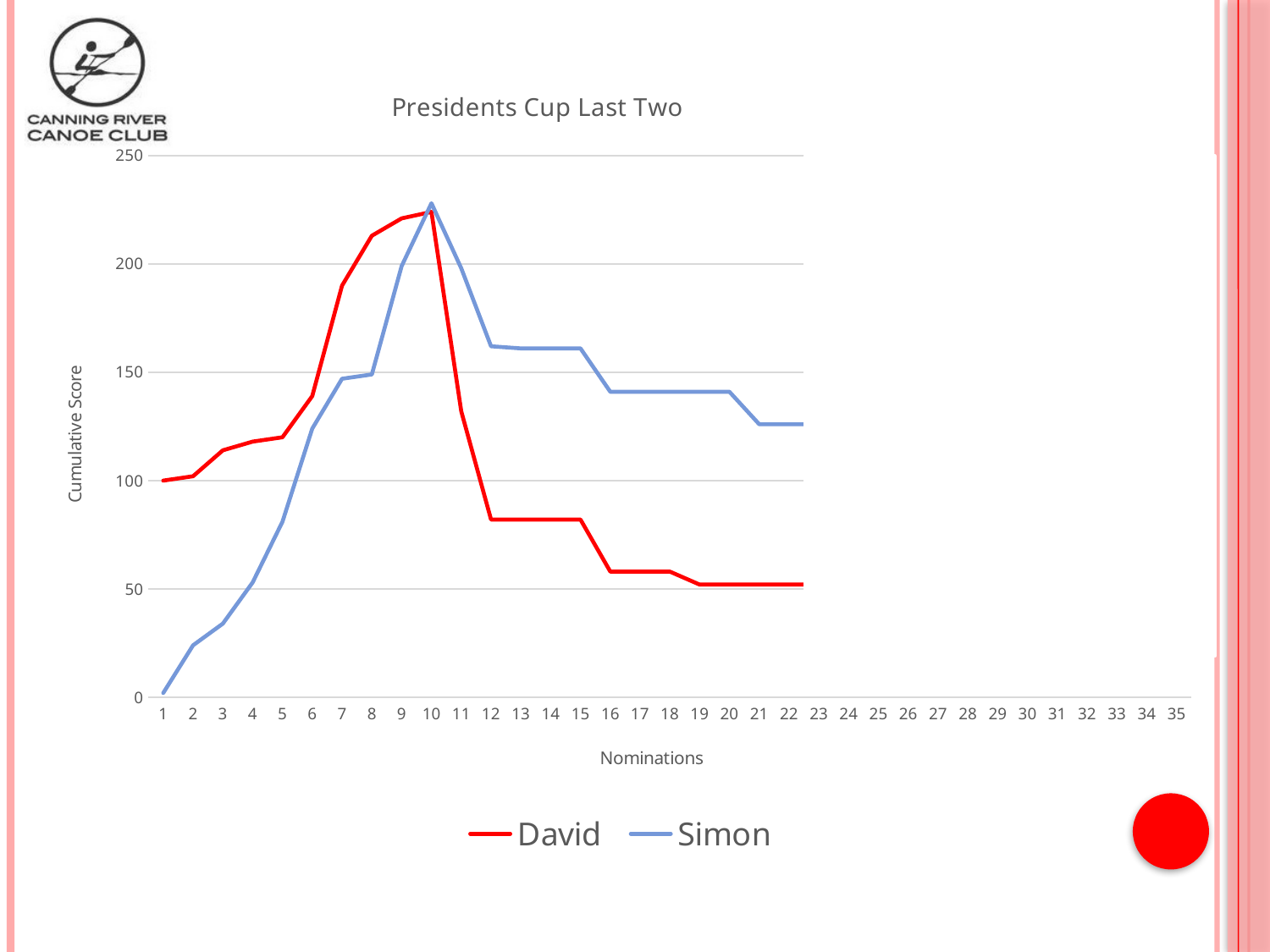
Is the value for David at nomination 10 greater or less than 200? greater Is the value for Simon at nomination 5 greater or less than 100? less Is the value for Simon at nomination 22 greater or less than 150? less What is the label on the vertical axis? Cumulative Score What is the title of the chart? Presidents Cup Last Two Does the David line rise or fall between nomination 10 and nomination 12? fall What kind of chart is shown on the slide? line chart How many series does the legend list? 2 At nomination 22, which series has the higher value, David or Simon? Simon At nomination 5, which series has the higher value, David or Simon? David